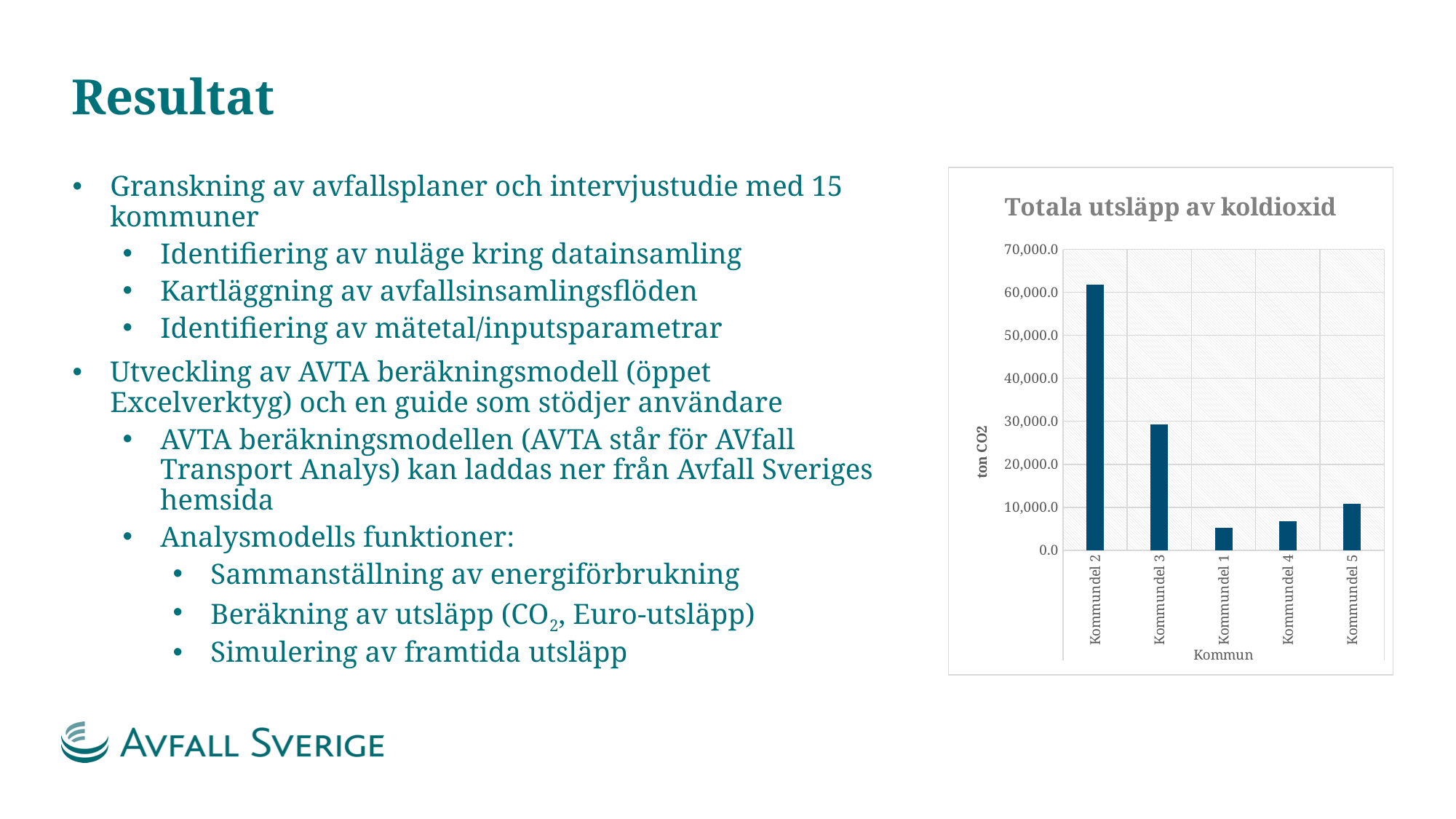
Is the value for Kommundel 2 greater or less than 50,000.0? greater What kind of chart is shown on the slide? bar chart Which has higher emissions in the chart, Kommundel 4 or Kommundel 5? Kommundel 5 What is the title of the chart? Totala utsläpp av koldioxid How many categories (kommundelar) are plotted in the chart? 5 What is the label of the vertical axis of the chart? ton CO2 Is the value for Kommundel 3 greater or less than 20,000.0? greater Is the value for Kommundel 1 greater or less than 10,000.0? less Which has higher emissions in the chart, Kommundel 3 or Kommundel 5? Kommundel 3 Which kommundel has the lowest total carbon dioxide emissions in the chart? Kommundel 1 Which kommundel has the highest total carbon dioxide emissions in the chart? Kommundel 2